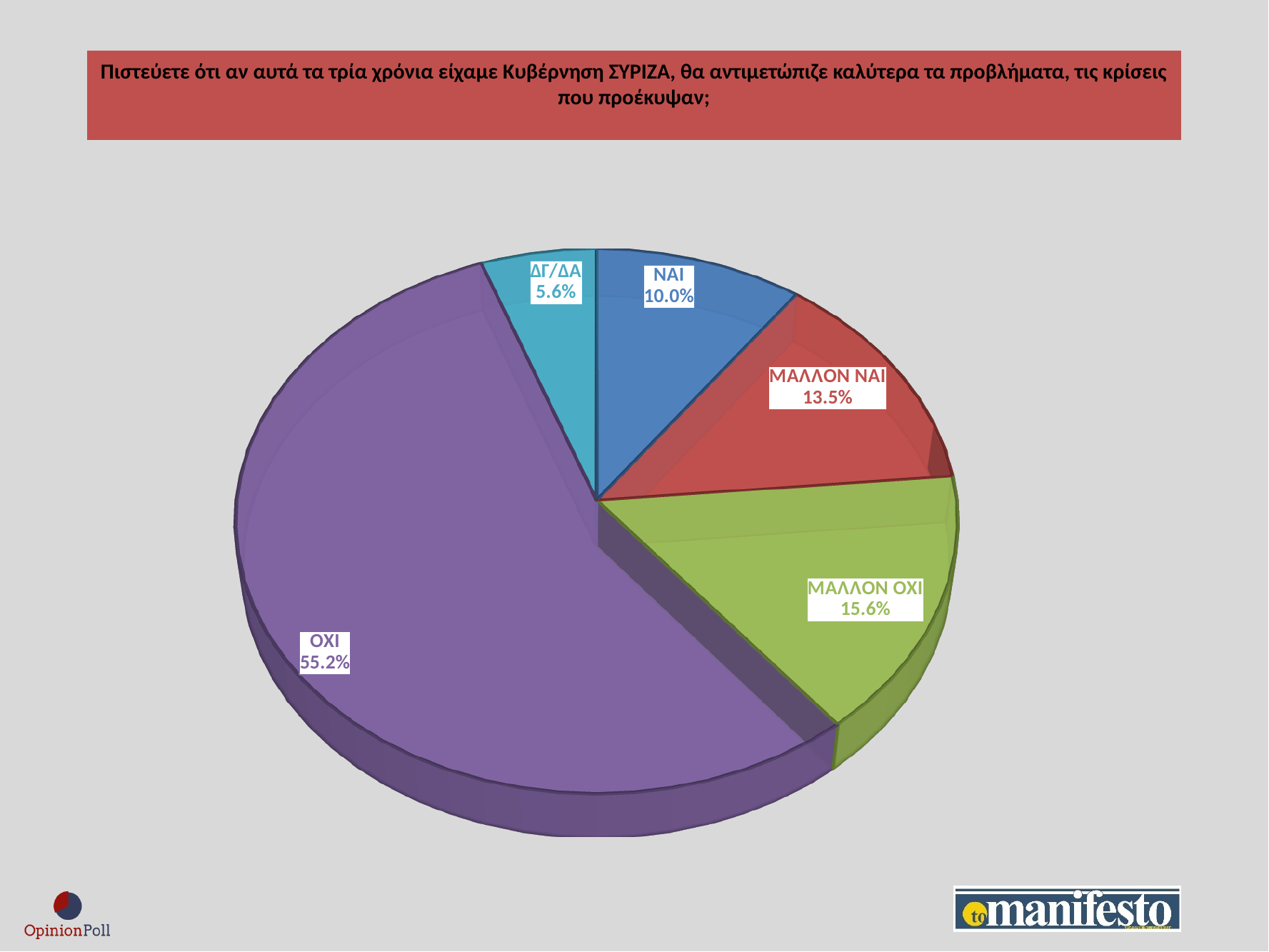
What kind of chart is shown on the slide? pie chart What percentage is shown for ΜΑΛΛΟΝ ΝΑΙ? 13.5% Which slice of the pie is the smallest? ΔΓ/ΔΑ What percentage is shown for ΜΑΛΛΟΝ ΟΧΙ? 15.6% What percentage is shown for ΟΧΙ? 55.2% Which slice of the pie is the largest? ΟΧΙ What percentage is shown for ΝΑΙ? 10.0% What is the difference in percentage points between ΟΧΙ and ΜΑΛΛΟΝ ΟΧΙ? 39.6 What colour is the ΟΧΙ slice? purple What percentage is shown for ΔΓ/ΔΑ? 5.6% Which is larger, ΜΑΛΛΟΝ ΟΧΙ or ΜΑΛΛΟΝ ΝΑΙ? ΜΑΛΛΟΝ ΟΧΙ How many slices does the pie chart have? 5